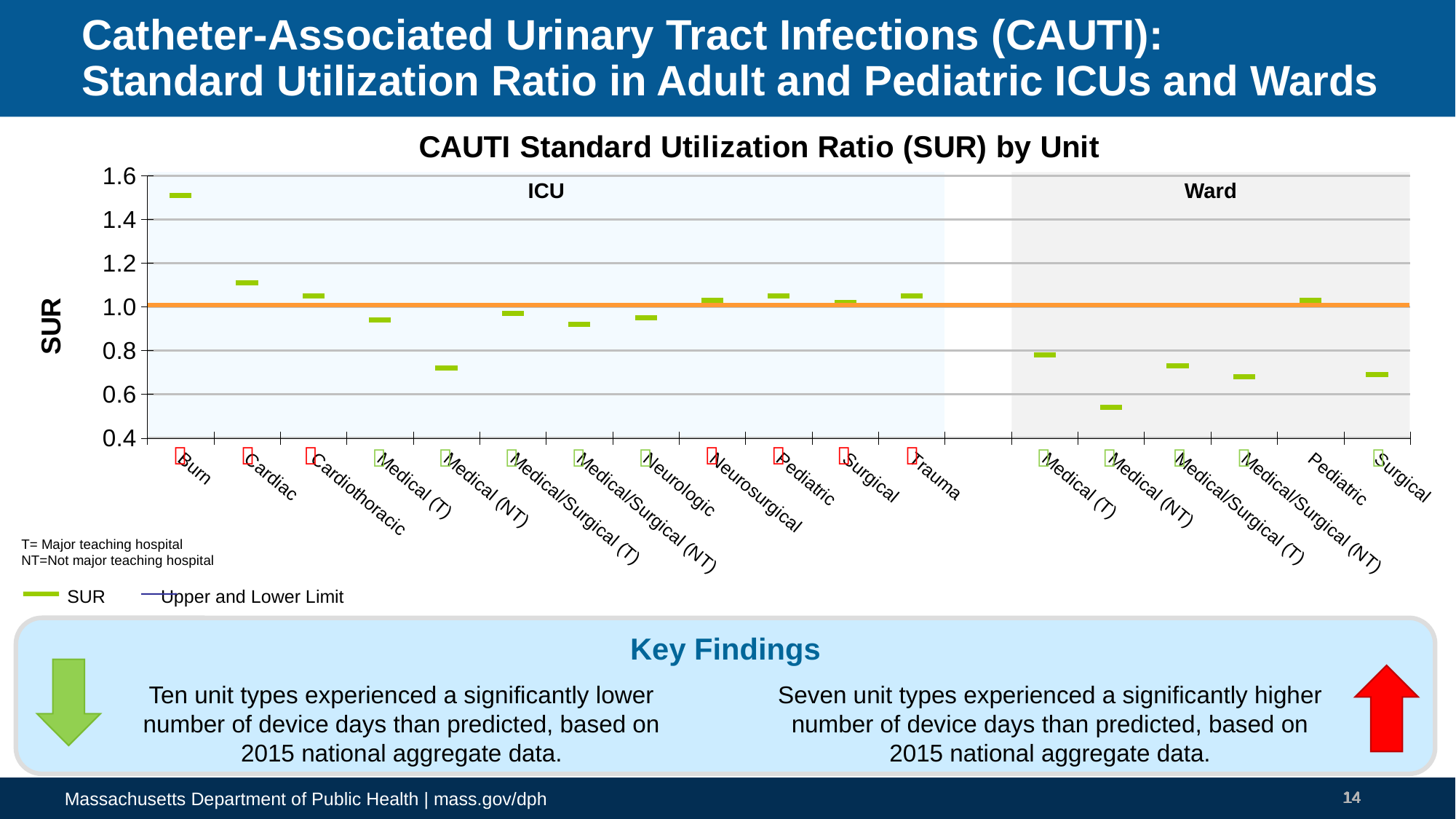
What is the title of the chart? CAUTI Standard Utilization Ratio (SUR) by Unit How many unit types are plotted in the Ward section of the chart? 6 Which has a higher SUR, the Burn ICU or the Cardiac ICU? Burn How many unit types are plotted on the chart in total? 18 Which unit has the highest SUR on the chart? Burn Which unit has the lowest SUR on the chart? Medical (NT) in the Ward section Is the SUR for the Cardiac ICU greater or less than 1.0? greater Is the SUR for the Medical (NT) ICU greater or less than 0.8? less Which has a higher SUR, the Medical (NT) ICU or the Medical (NT) ward? Medical (NT) ICU How many entries does the chart legend list? 2 Is the SUR for the Burn ICU greater or less than 1.4? greater